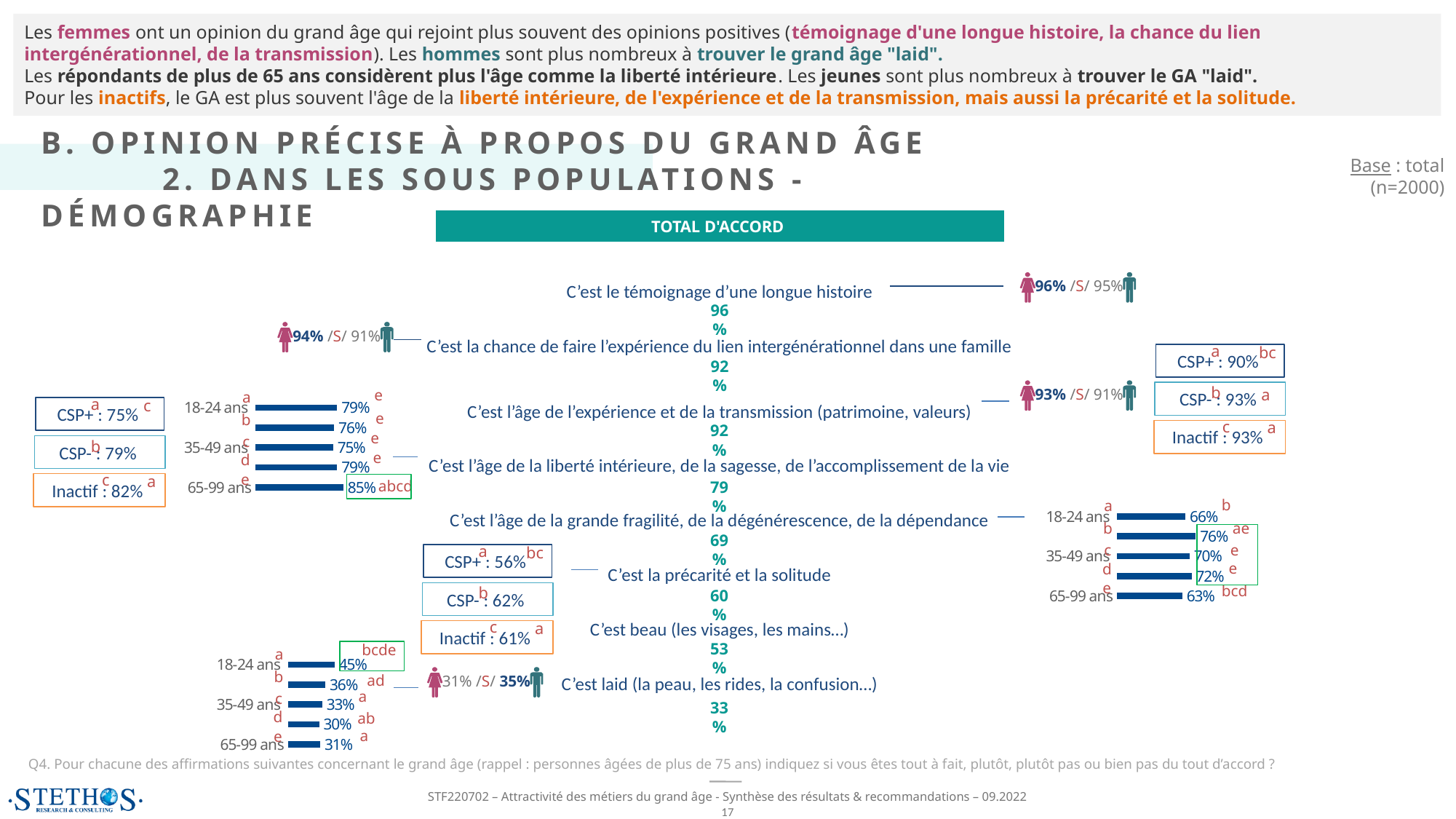
In the bar chart at the bottom left of the slide (next to 'C'est laid'), what is the value for 18-24 ans? 45% In the bar chart on the right of the slide (next to 'C'est l'âge de la grande fragilité'), what is the difference between the values for 18-24 ans and 65-99 ans? 3 points In the bar chart on the right of the slide (next to 'C'est l'âge de la grande fragilité'), which labelled age group has the lowest value? 65-99 ans In the bar chart on the left of the slide (next to 'C'est l'âge de la liberté intérieure'), what is the value for 18-24 ans? 79% In the bar chart on the left of the slide (next to 'C'est l'âge de la liberté intérieure'), what is the value for 65-99 ans? 85% In the bar chart on the left of the slide (next to 'C'est l'âge de la liberté intérieure'), which age group has the highest value? 65-99 ans What is the 'TOTAL D'ACCORD' percentage for 'C'est laid (la peau, les rides, la confusion...)'? 33% In the bar chart at the bottom left of the slide (next to 'C'est laid'), which is larger, the value for 35-49 ans or the value for 65-99 ans? 35-49 ans How many bars does the bar chart at the bottom left of the slide (next to 'C'est laid') contain? 5 What type of chart is used for the age-group breakdowns on the slide? Bar chart In the bar chart on the right of the slide (next to 'C'est l'âge de la grande fragilité'), what is the value for 35-49 ans? 70% What is the 'TOTAL D'ACCORD' percentage for 'C'est le témoignage d'une longue histoire'? 96%